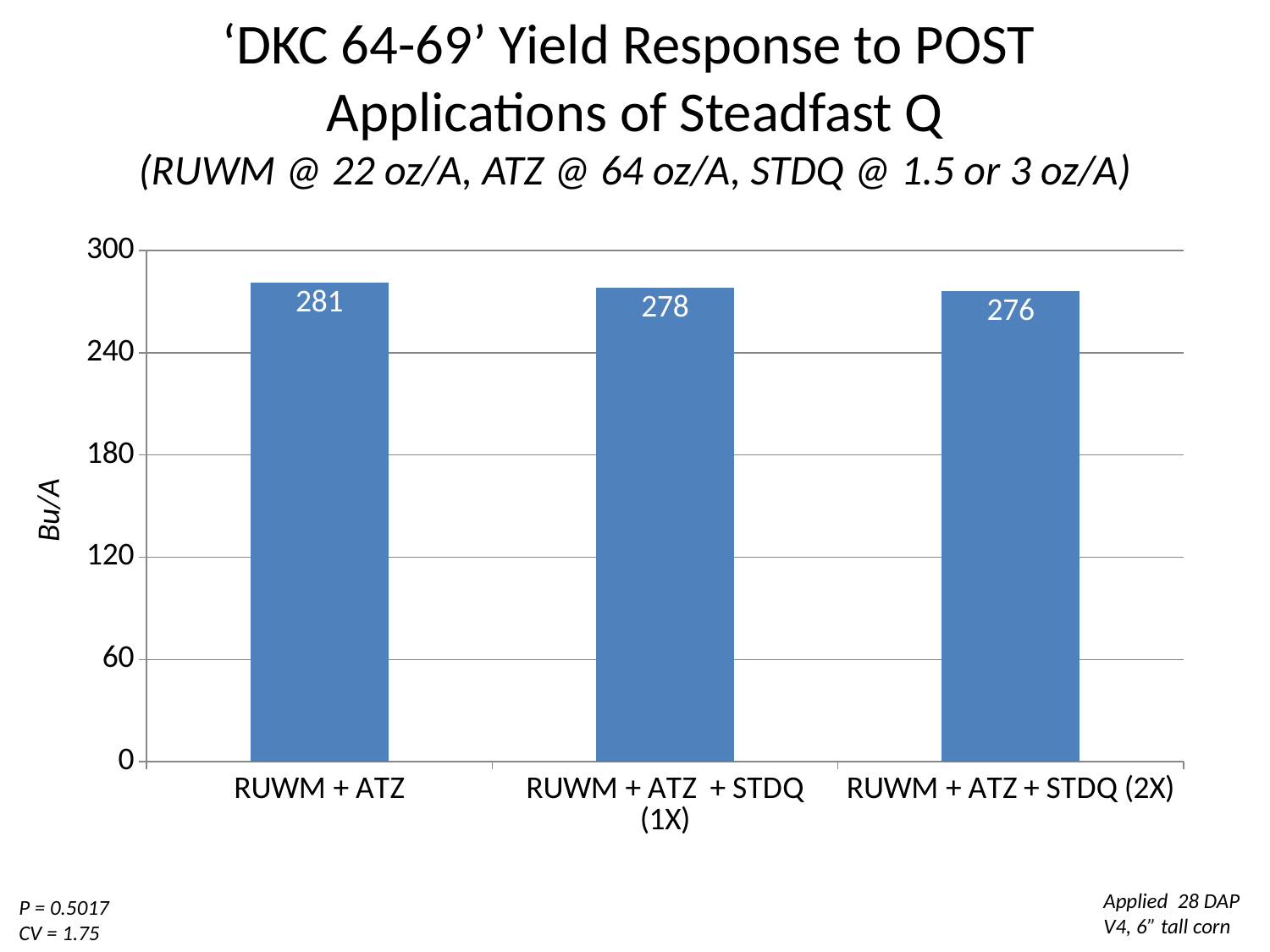
Which treatment has the lowest yield? RUWM + ATZ + STDQ (2X) What is the label of the y axis? Bu/A What is the yield value for RUWM + ATZ + STDQ (2X)? 276 What is the difference in yield between RUWM + ATZ and RUWM + ATZ + STDQ (2X)? 5 What kind of chart is shown on the slide? bar chart Which treatment has the highest yield? RUWM + ATZ What is the yield value for RUWM + ATZ? 281 Which has a higher yield, RUWM + ATZ or RUWM + ATZ + STDQ (1X)? RUWM + ATZ What is the difference in yield between RUWM + ATZ + STDQ (1X) and RUWM + ATZ + STDQ (2X)? 2 Is the value for RUWM + ATZ + STDQ (2X) greater or less than 240? greater What is the yield value for RUWM + ATZ + STDQ (1X)? 278 How many treatments are shown in the chart? 3